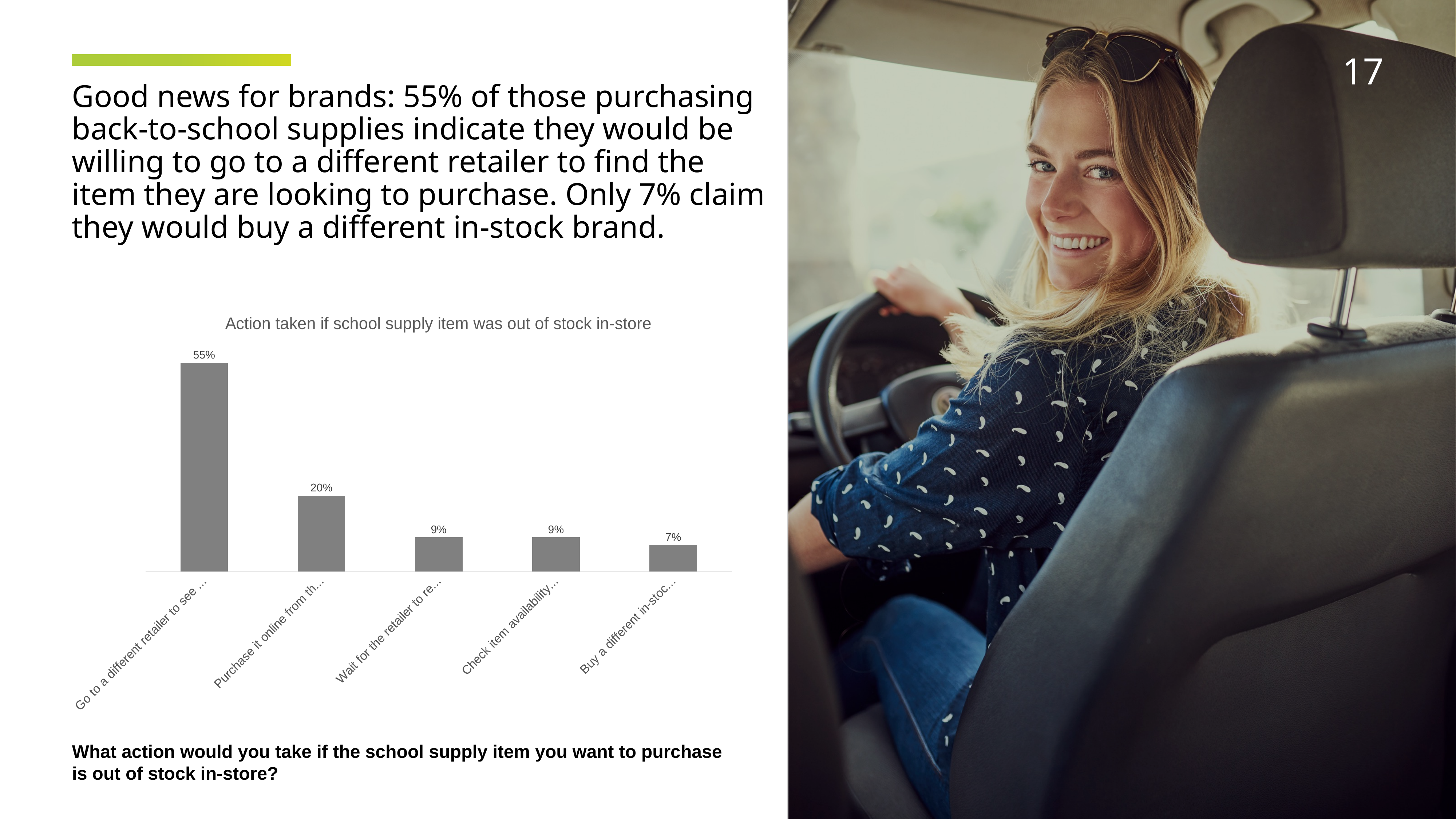
What value is shown for the bar labelled "Wait for the retailer to re..."? 9% What value is shown for the bar labelled "Buy a different in-stoc..."? 7% What is the title of the chart? Action taken if school supply item was out of stock in-store What kind of chart is shown on the slide? Bar chart Which is larger, the value for "Purchase it online from th..." or the value for "Wait for the retailer to re..."? Purchase it online from th... What is the difference between the values for "Go to a different retailer to see ..." and "Purchase it online from th..."? 35% Which category has the highest value in the chart? Go to a different retailer to see ... What value is shown for the bar labelled "Purchase it online from th..."? 20% How many categories (bars) are shown in the chart? 5 What is the difference between the values for "Check item availability..." and "Buy a different in-stoc..."? 2% Which category has the lowest value in the chart? Buy a different in-stoc... What value is shown for the bar labelled "Go to a different retailer to see ..."? 55%